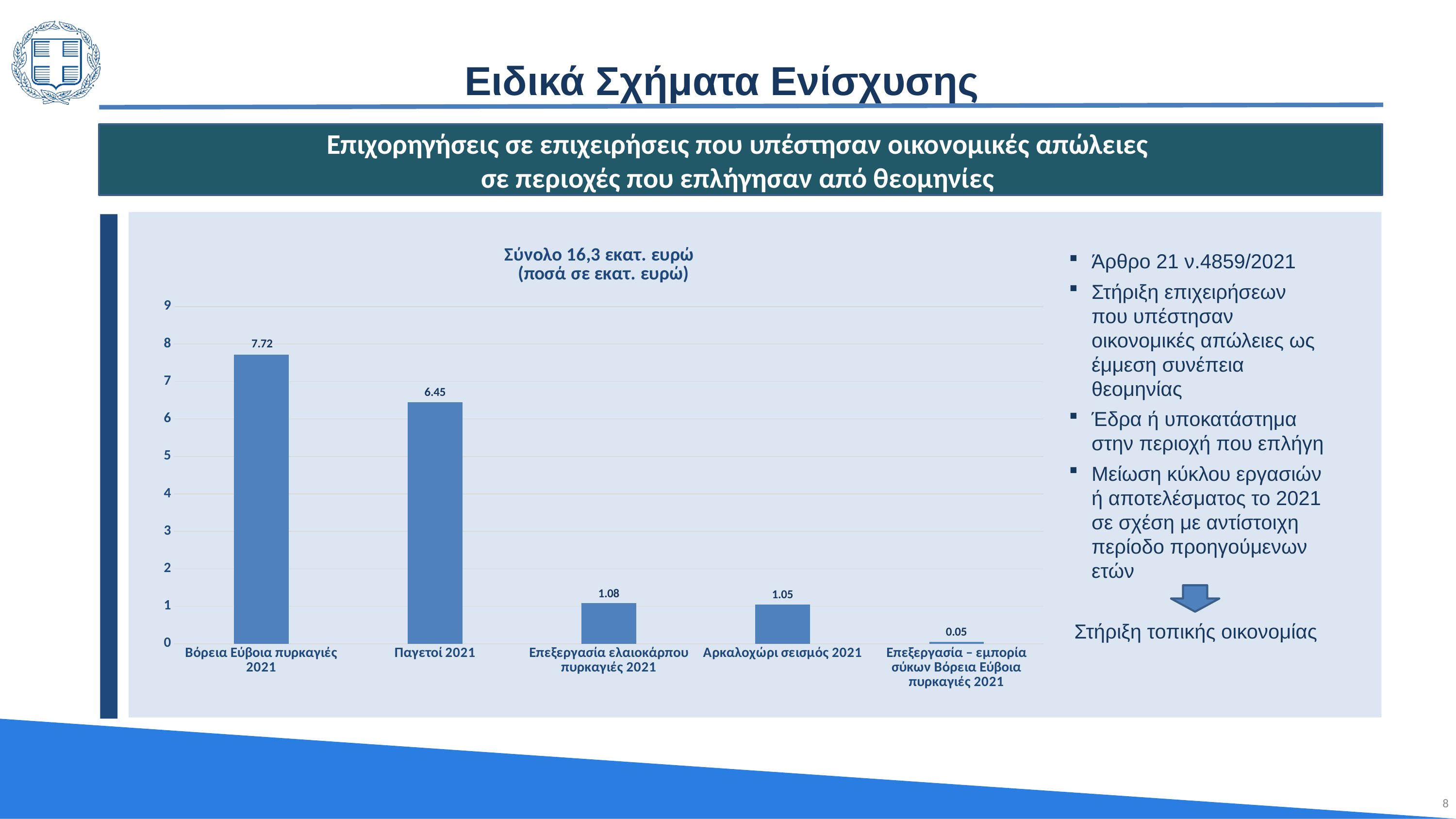
What is the value for Παγετοί 2021? 6.45 What total amount is stated in the chart title? 16,3 εκατ. ευρώ What is the value for Αρκαλοχώρι σεισμός 2021? 1.05 Is the value for Παγετοί 2021 greater or less than 7? less How many categories are shown in the chart? 5 What is the value for Βόρεια Εύβοια πυρκαγιές 2021? 7.72 What is the difference between the values for Βόρεια Εύβοια πυρκαγιές 2021 and Παγετοί 2021? 1.27 Which category has the lowest value? Επεξεργασία – εμπορία σύκων Βόρεια Εύβοια πυρκαγιές 2021 Which is larger, the value for Παγετοί 2021 or the value for Επεξεργασία ελαιοκάρπου πυρκαγιές 2021? Παγετοί 2021 What kind of chart is shown on the slide? bar chart Which category has the highest value? Βόρεια Εύβοια πυρκαγιές 2021 What is the value for Επεξεργασία – εμπορία σύκων Βόρεια Εύβοια πυρκαγιές 2021? 0.05